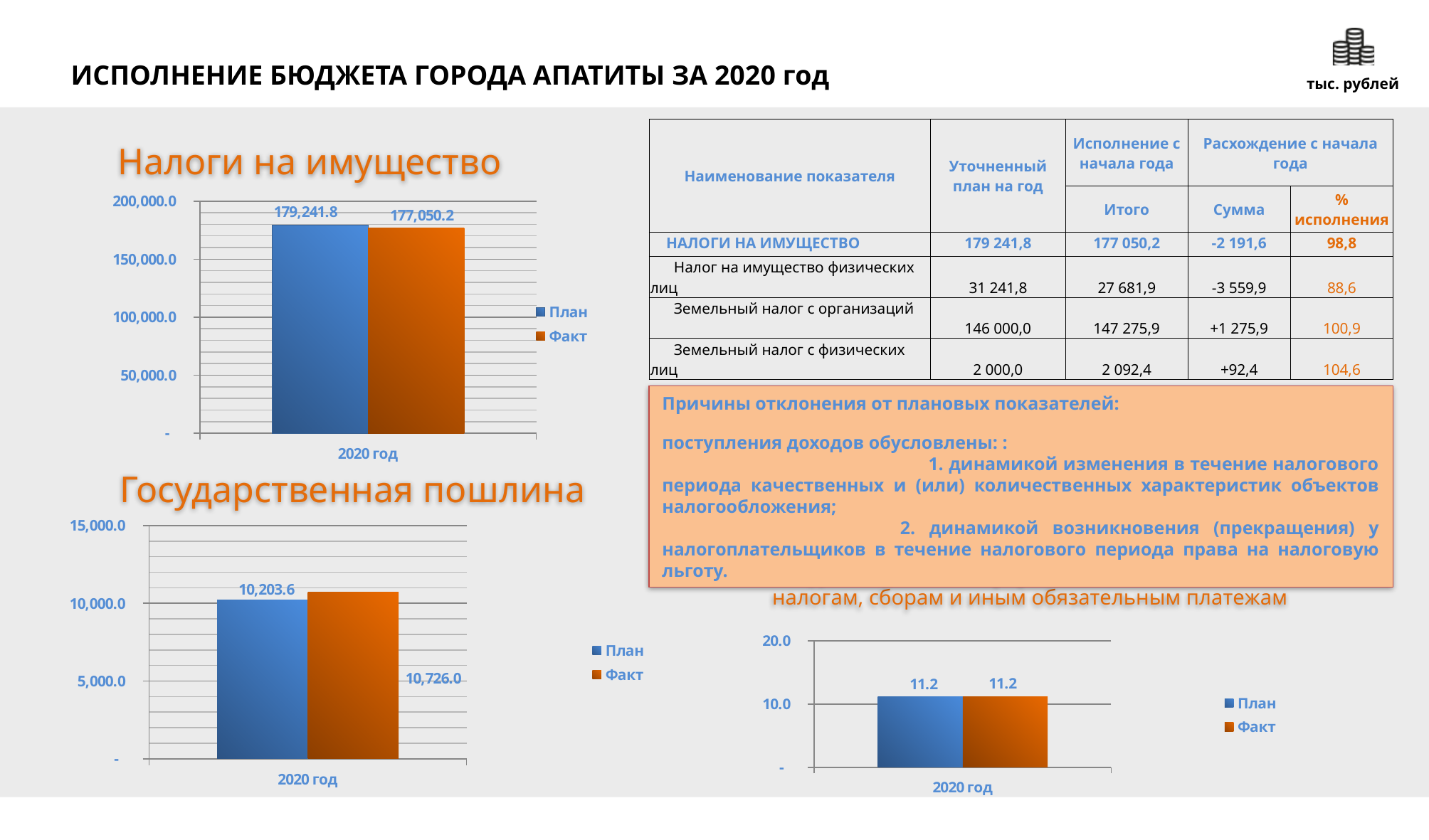
In the 'Государственная пошлина' chart, what is the value for Факт? 10,726.0 In the chart at the bottom right of the slide, is the value for План greater or less than 10.0? greater In the chart at the bottom right of the slide, what is the value for Факт? 11.2 In the 'Налоги на имущество' chart, which is larger, План or Факт? План How many series does the legend of the 'Государственная пошлина' chart list? 2 What kind of chart is the 'Налоги на имущество' chart? bar chart In the 'Налоги на имущество' chart, what is the difference between План and Факт? 2,191.6 In the 'Государственная пошлина' chart, which is larger, План or Факт? Факт In the 'Государственная пошлина' chart, what is the value for План? 10,203.6 In the 'Налоги на имущество' chart, what is the value for Факт? 177,050.2 In the 'Налоги на имущество' chart, what is the value for План? 179,241.8 In the 'Государственная пошлина' chart, what is the difference between Факт and План? 522.4